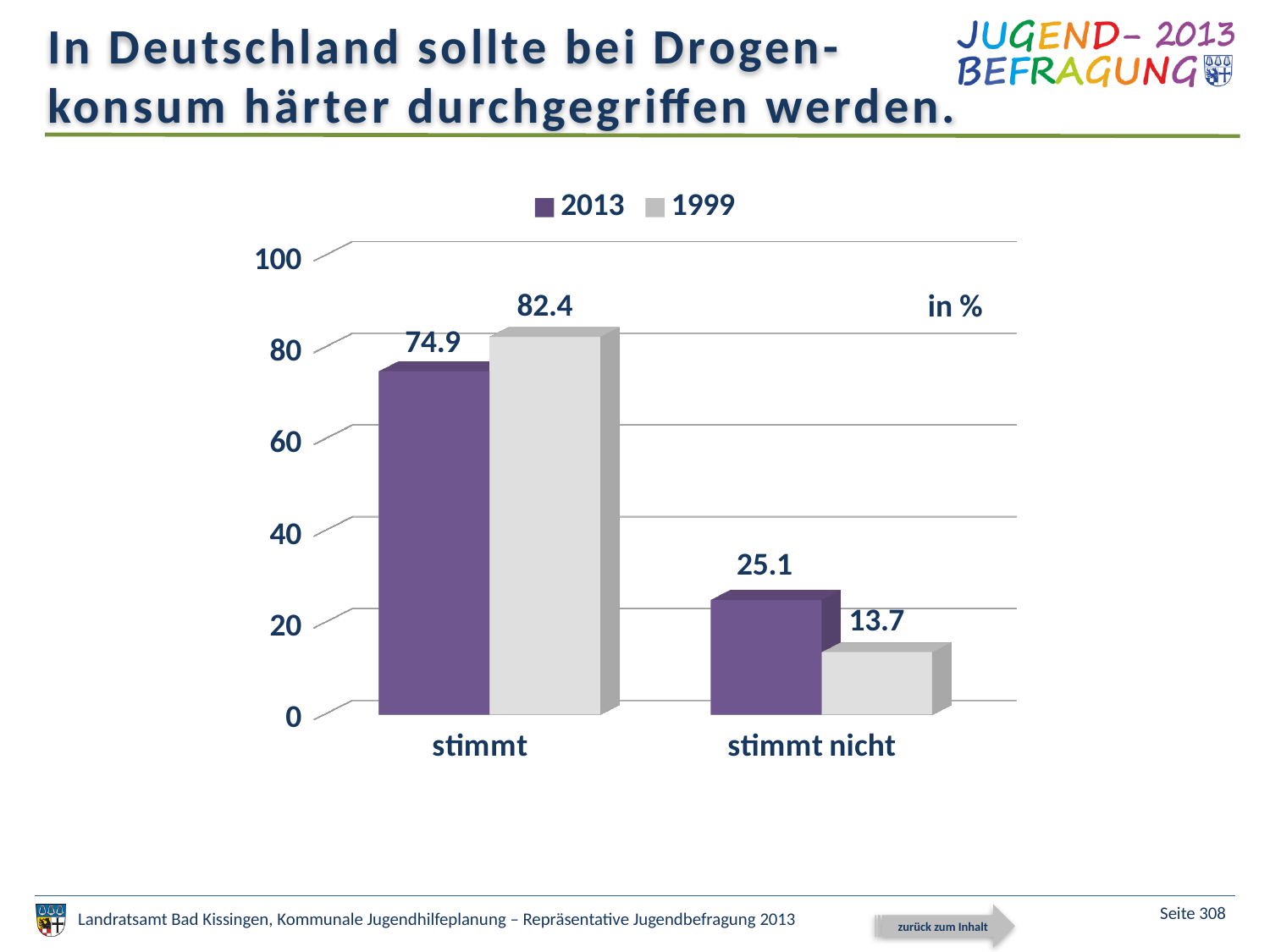
How many categories are shown on the x axis? 2 What is the value for "stimmt nicht" in the 2013 series? 25.1 What is the value for "stimmt" in the 1999 series? 82.4 Which category has the highest value in the 1999 series? stimmt What is the difference between the 1999 and 2013 values for "stimmt"? 7.5 What kind of chart is shown on the slide? bar chart What is the difference between the 2013 and 1999 values for "stimmt nicht"? 11.4 What is the value for "stimmt" in the 2013 series? 74.9 What is the value for "stimmt nicht" in the 1999 series? 13.7 How many series does the legend list? 2 Which category has the lowest value in the 2013 series? stimmt nicht Which series has the larger value for "stimmt nicht", 2013 or 1999? 2013